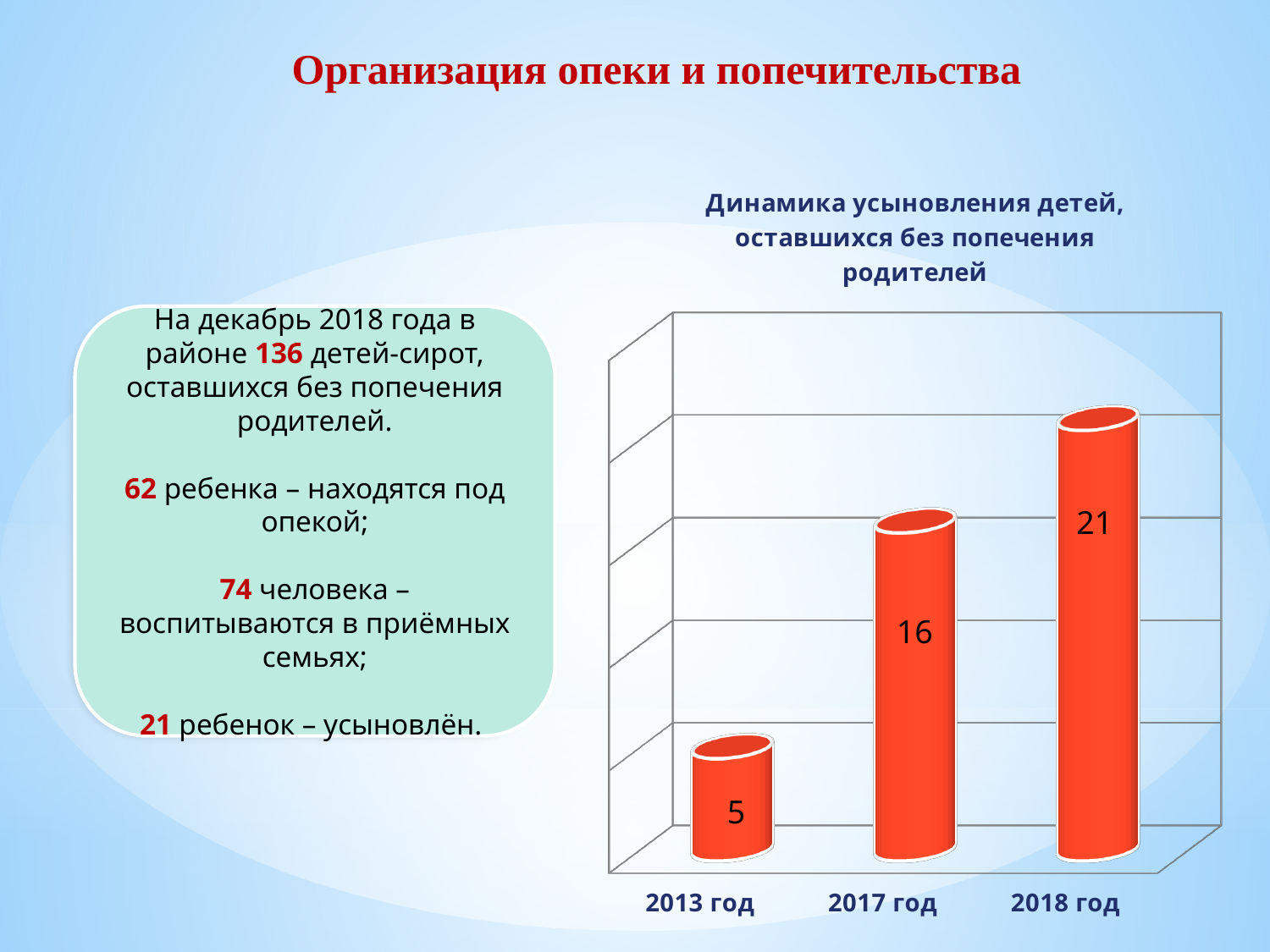
How many categories are shown on the x axis? 3 What kind of chart is shown? bar chart Which year has the highest value? 2018 год What is the value for 2013 год? 5 What is the difference between the values for 2018 год and 2013 год? 16 What is the value for 2018 год? 21 Which year has the lowest value? 2013 год Which is larger, the value for 2017 год or the value for 2013 год? 2017 год Do the values rise or fall from 2013 год to 2018 год? rise What is the value for 2017 год? 16 What is the difference between the values for 2018 год and 2017 год? 5 What is the title of the chart? Динамика усыновления детей, оставшихся без попечения родителей